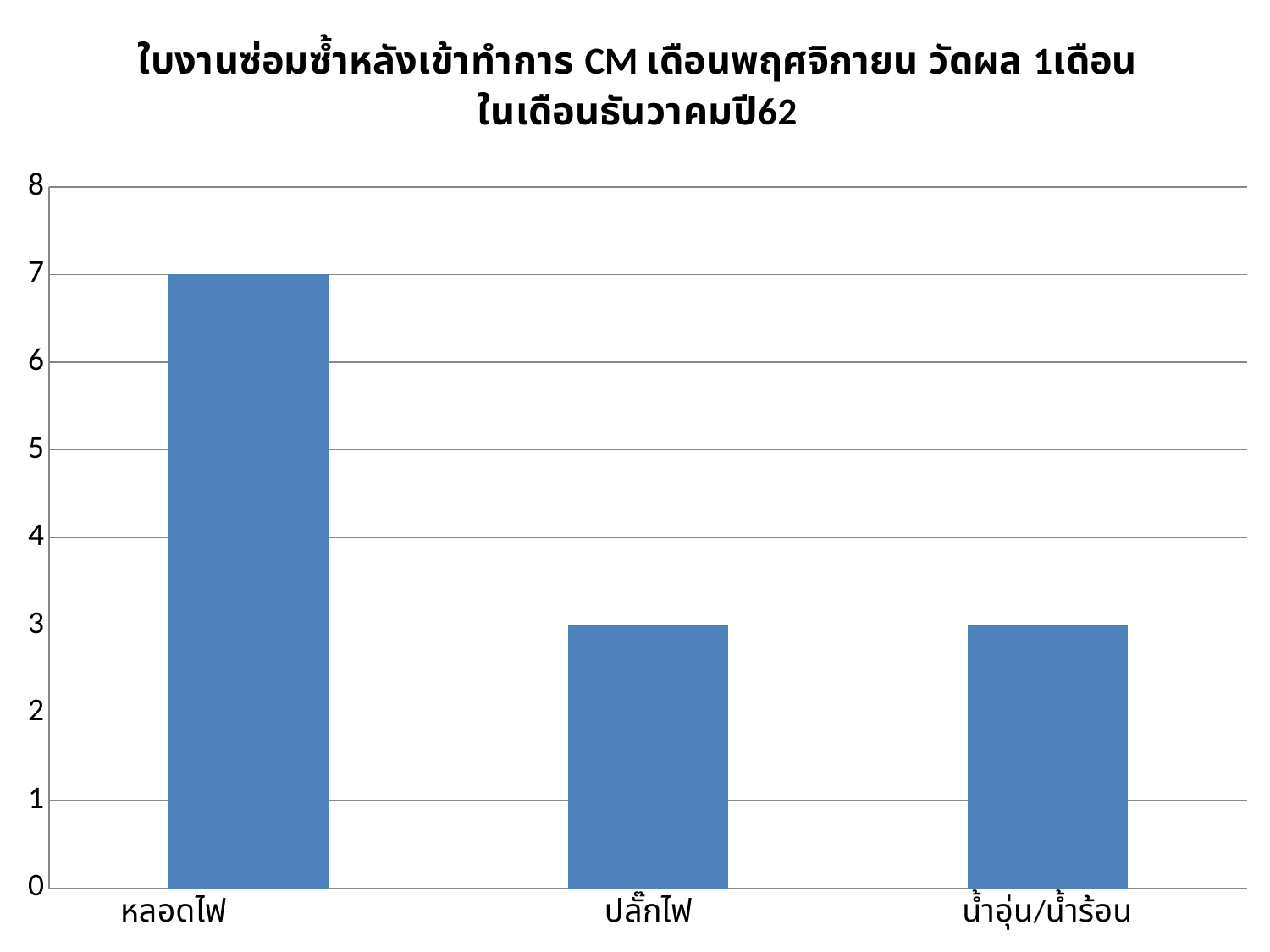
How many categories are shown on the x axis? 3 What kind of chart is shown on the slide? bar chart Which category has the highest value? หลอดไฟ What is the maximum value shown on the vertical axis? 8 What is the difference between the values for หลอดไฟ and น้ำอุ่น/น้ำร้อน? 4 Is the value for น้ำอุ่น/น้ำร้อน greater or less than 4? less What is the difference between the values for หลอดไฟ and ปลั๊กไฟ? 4 What is the value for หลอดไฟ? 7 What is the value for น้ำอุ่น/น้ำร้อน? 3 Is the value for หลอดไฟ greater or less than 5? greater What is the value for ปลั๊กไฟ? 3 Which is larger, the value for หลอดไฟ or the value for ปลั๊กไฟ? หลอดไฟ